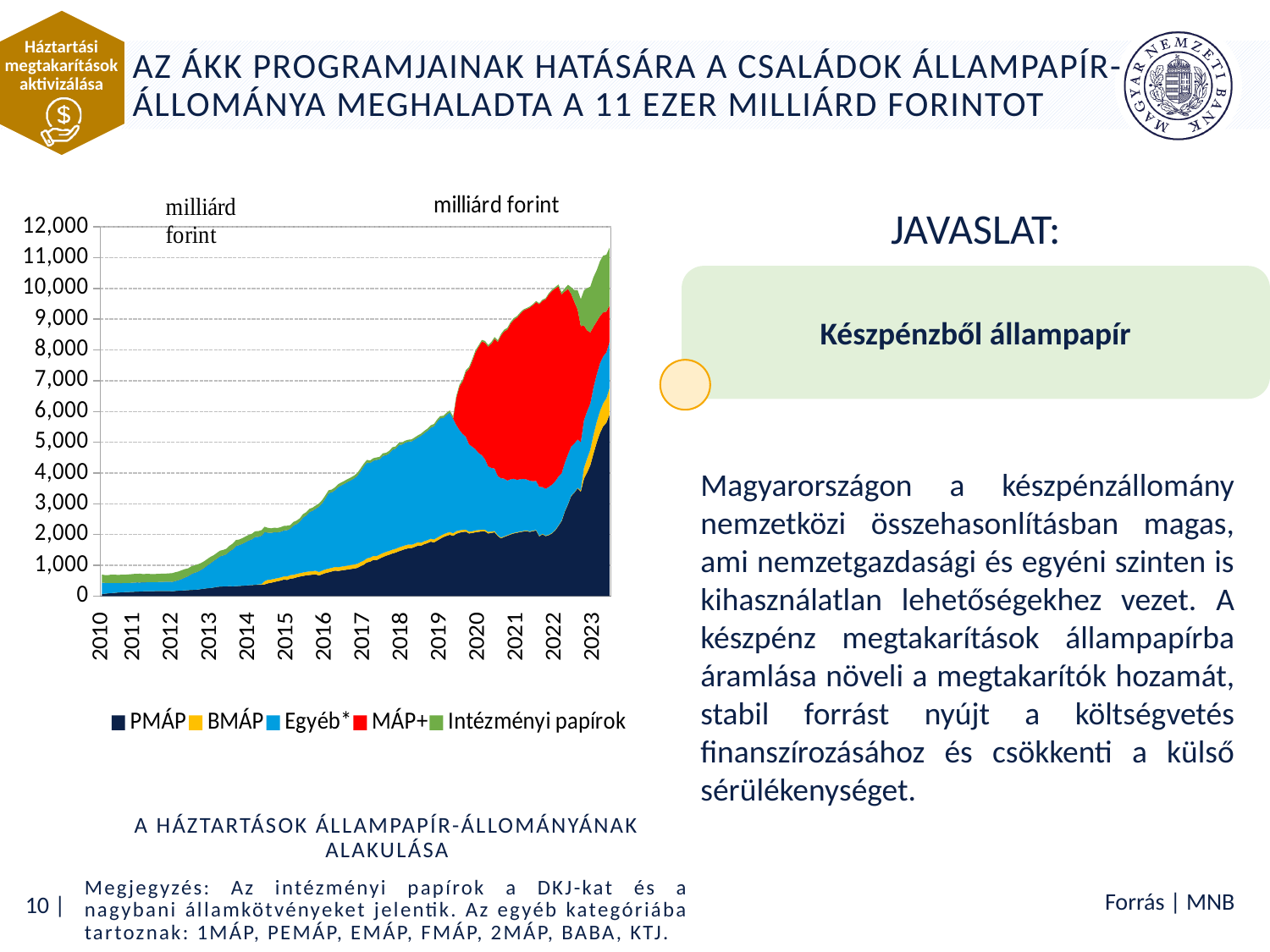
How many years are labelled on the x axis of the chart? 14 Is the total stock at the start of 2019 greater or less than 5,000 milliárd forint? greater How many series does the chart legend list? 5 Is the total stock in 2010 greater or less than 1,000 milliárd forint? less Is the total stock at the end of 2023 greater or less than 10,000 milliárd forint? greater Which series is shown in red in the chart legend? MÁP+ What kind of chart is shown on the slide? Stacked area chart What is the highest value shown on the y axis of the chart? 12,000 Does the total household government securities stock rise or fall from 2010 to 2023? Rises